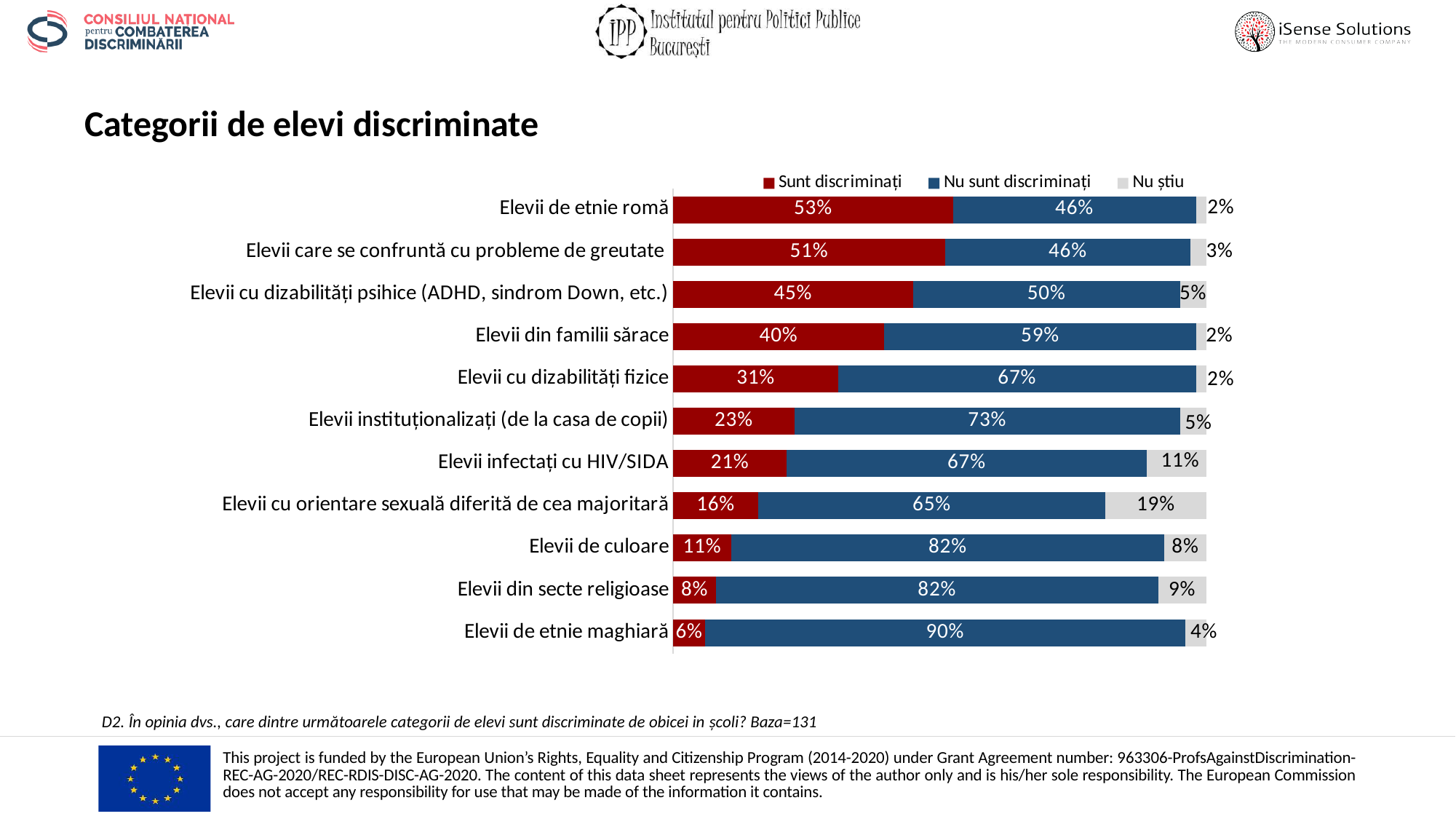
What percentage of respondents said 'Sunt discriminați' for 'Elevii de etnie romă'? 53% What kind of chart is shown on the slide? Stacked bar chart What is the difference between the 'Sunt discriminați' values for 'Elevii de etnie romă' and 'Elevii de etnie maghiară'? 47% What is the 'Nu sunt discriminați' value for 'Elevii din familii sărace'? 59% How many series does the legend list? 3 What is the title of the slide? Categorii de elevi discriminate How many categories of students are shown in the chart? 11 Which category has the highest 'Sunt discriminați' value? Elevii de etnie romă Which category has the highest 'Nu știu' value? Elevii cu orientare sexuală diferită de cea majoritară What is the 'Nu știu' value for 'Elevii cu orientare sexuală diferită de cea majoritară'? 19% Which category has the lowest 'Sunt discriminați' value? Elevii de etnie maghiară Which has a larger 'Sunt discriminați' value: 'Elevii cu dizabilități fizice' or 'Elevii infectați cu HIV/SIDA'? Elevii cu dizabilități fizice